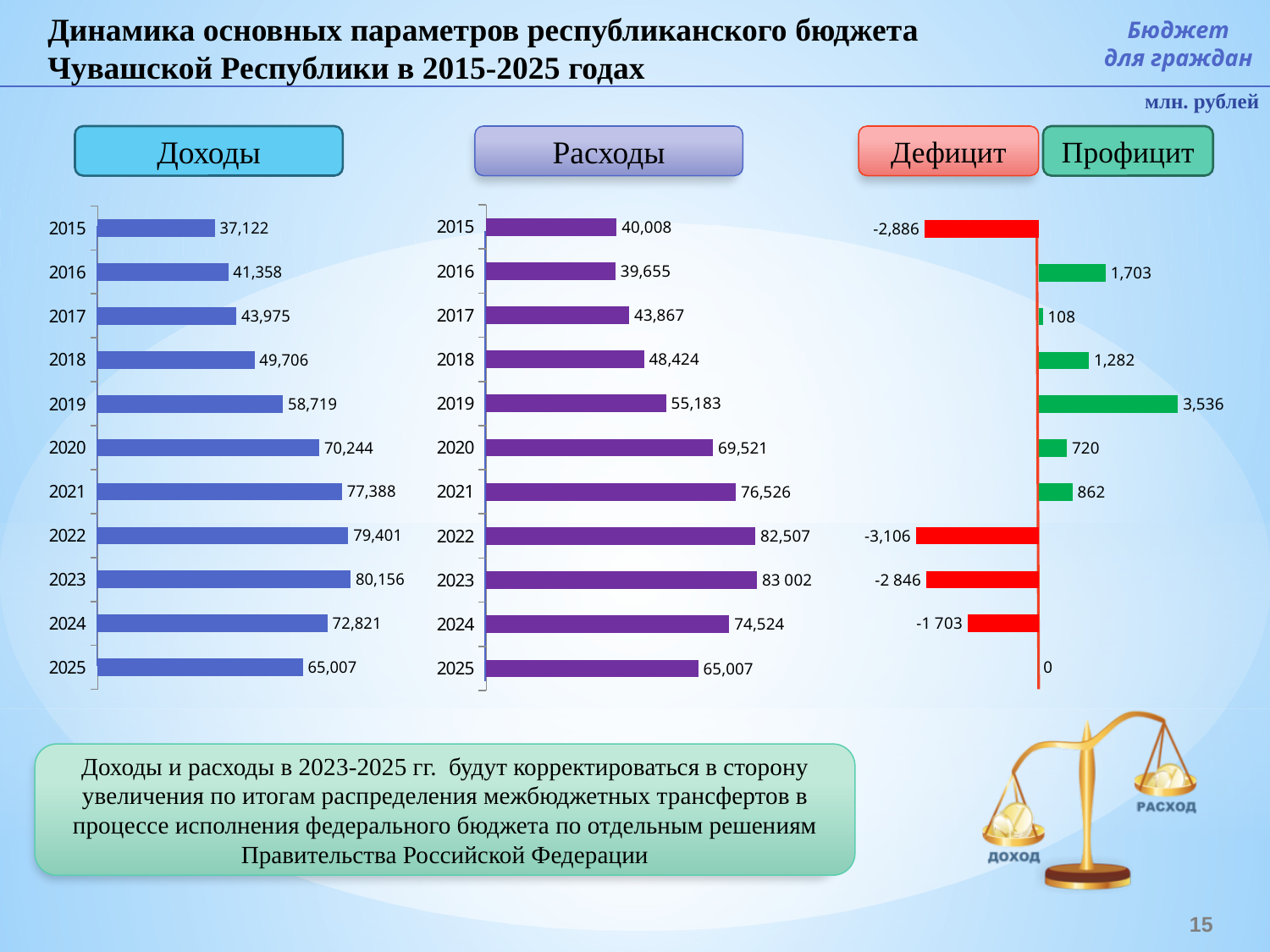
In the Доходы chart, what is the value for 2019? 58,719 What colour are the bars in the Расходы chart? Purple How many years are shown in the Доходы chart? 11 In the Доходы chart, do the values rise or fall from 2015 to 2023? Rise In the Расходы chart, which year has the lowest value? 2016 In the Доходы chart, what is the difference between the values for 2023 and 2024? 7,335 In the Расходы chart, what is the value for 2022? 82,507 In the Дефицит/Профицит chart, what is the value for 2019? 3,536 In the Дефицит/Профицит chart, which year has the largest surplus (green bar)? 2019 What kind of chart is the Расходы chart? Bar chart For 2018, which is larger: the Доходы value or the Расходы value? Доходы In the Доходы chart, which year has the highest value? 2023